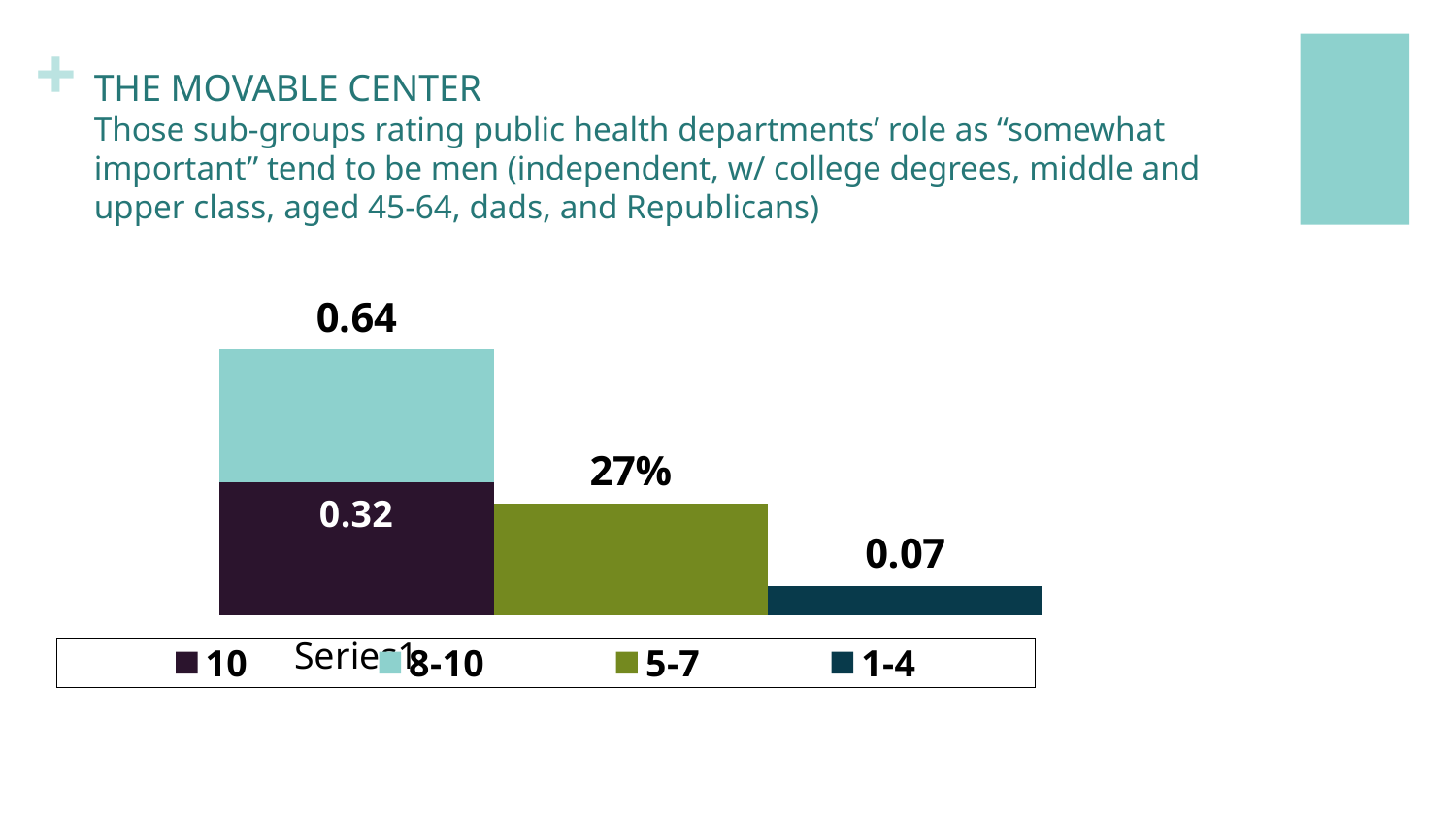
What is the value labelled for the "5-7" series? 27% Which is larger, the value for "10" or the value for "1-4"? 10 What is the value labelled for the "1-4" series? 0.07 What value is printed at the top of the tallest bar? 0.64 What is the difference between the value for "10" and the value for "1-4"? 0.25 What are the entries in the chart legend? 10, 8-10, 5-7, 1-4 Which series has the lowest value? 1-4 What kind of chart is shown on the slide? bar chart How many series does the legend list? 4 What colour is the "5-7" series in the chart? olive green Which is larger, the value for "10" or the value for "5-7"? 10 What is the value labelled for the "10" series? 0.32